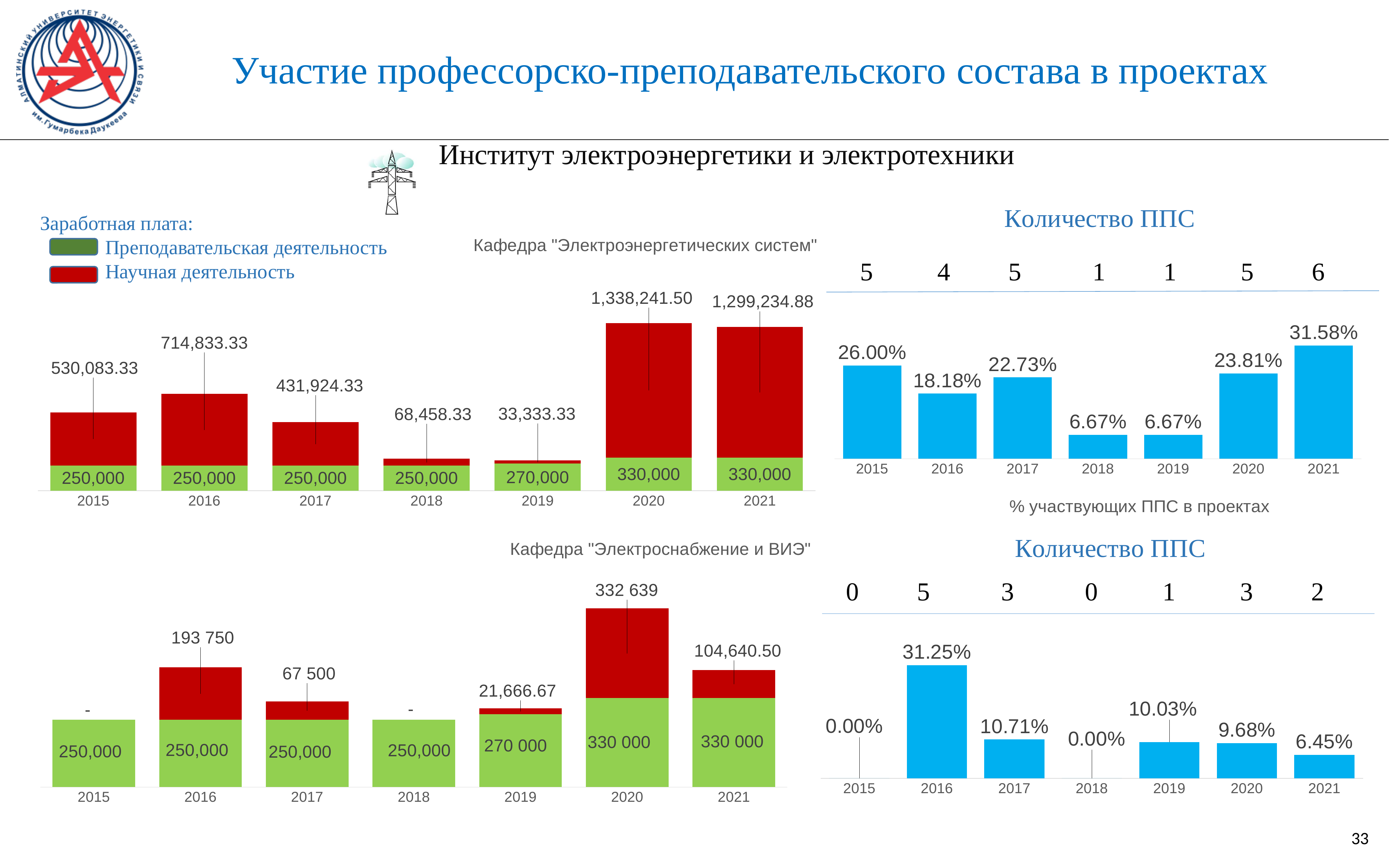
In the chart titled Кафедра "Электроэнергетических систем" (top left), what is the value of the Научная деятельность (red) segment for 2020? 1,338,241.50 In the top-right chart (% участвующих ППС в проектах), what is the difference between the values for 2015 and 2016? 7.82% What kind of chart is the top-left chart titled Кафедра "Электроэнергетических систем"? Stacked bar chart In the chart titled Кафедра "Электроснабжение и ВИЭ" (bottom left), which year has the highest Научная деятельность (red) value? 2020 In the chart titled Кафедра "Электроэнергетических систем" (top left), what is the total of the stacked bar for 2016? 964,833.33 In the chart titled Кафедра "Электроэнергетических систем" (top left), which year has the lowest Научная деятельность (red) value? 2019 In the chart titled Кафедра "Электроснабжение и ВИЭ" (bottom left), what is the Научная деятельность (red) value for 2020? 332 639 In the chart titled Кафедра "Электроснабжение и ВИЭ" (bottom left), how many years are shown on the x axis? 7 In the bottom-right chart (% участвующих ППС в проектах), which is larger: the value for 2019 or the value for 2020? 2019 In the bottom-right chart (% участвующих ППС в проектах), which year has the highest value? 2016 In the top-right chart (% участвующих ППС в проектах), what is the value for 2021? 31.58% In the chart titled Кафедра "Электроэнергетических систем" (top left), what is the value of the Преподавательская деятельность (green) segment for 2019? 270,000